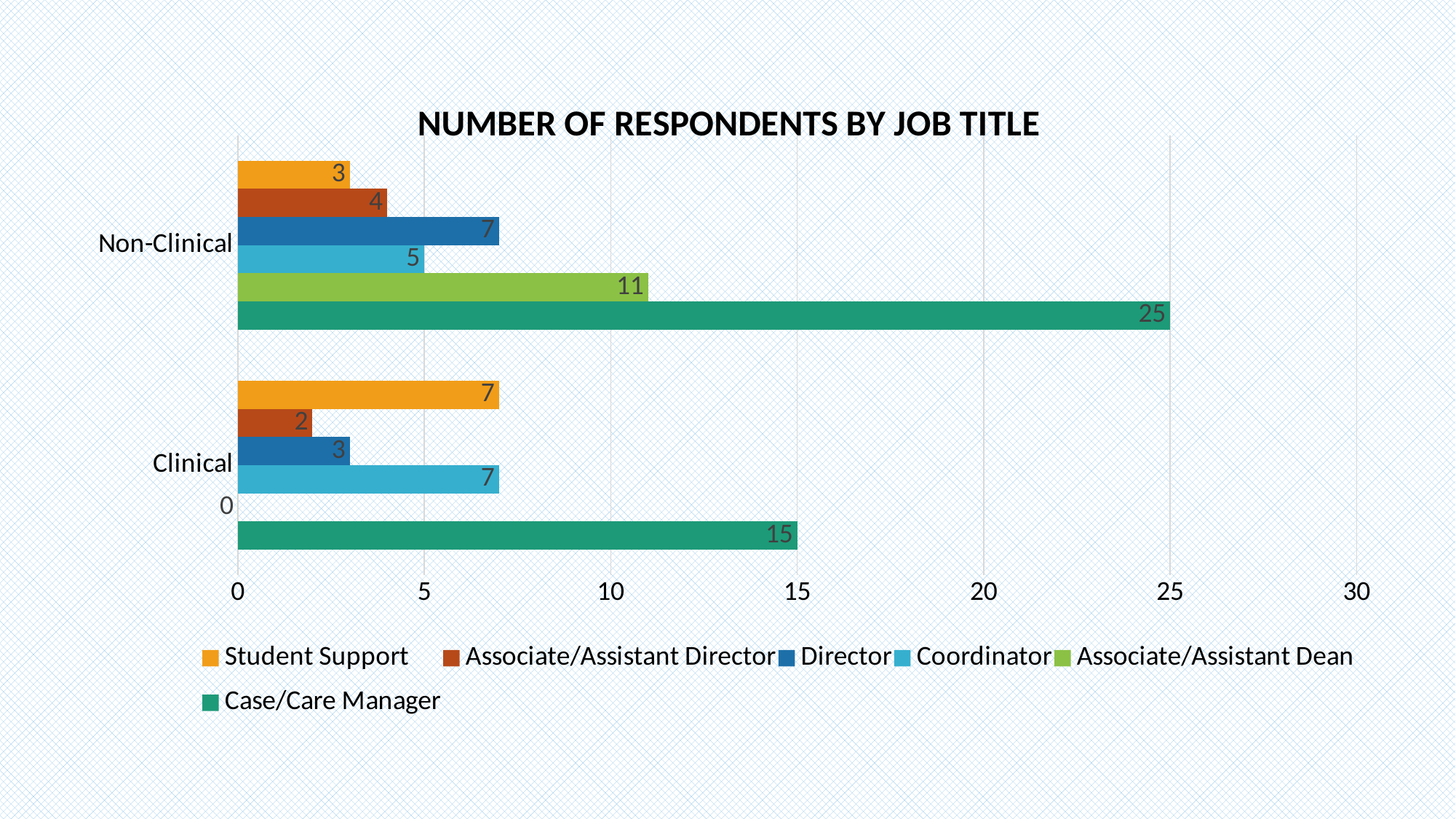
What is the number of Associate/Assistant Dean respondents in the Clinical category? 0 How many series does the legend list? 6 What is the number of Case/Care Manager respondents in the Non-Clinical category? 25 Which job title has the lowest number of respondents in the Non-Clinical category? Student Support Which job title has the highest number of respondents in the Clinical category? Case/Care Manager What kind of chart is shown on the slide? Bar chart What is the total number of Student Support respondents across both categories? 10 What is the difference between the Case/Care Manager respondents in the Non-Clinical and Clinical categories? 10 Which has more respondents: Director in Non-Clinical or Director in Clinical? Director in Non-Clinical What is the number of Coordinator respondents in the Non-Clinical category? 5 How many categories are shown on the vertical axis? 2 What is the title of the chart? NUMBER OF RESPONDENTS BY JOB TITLE